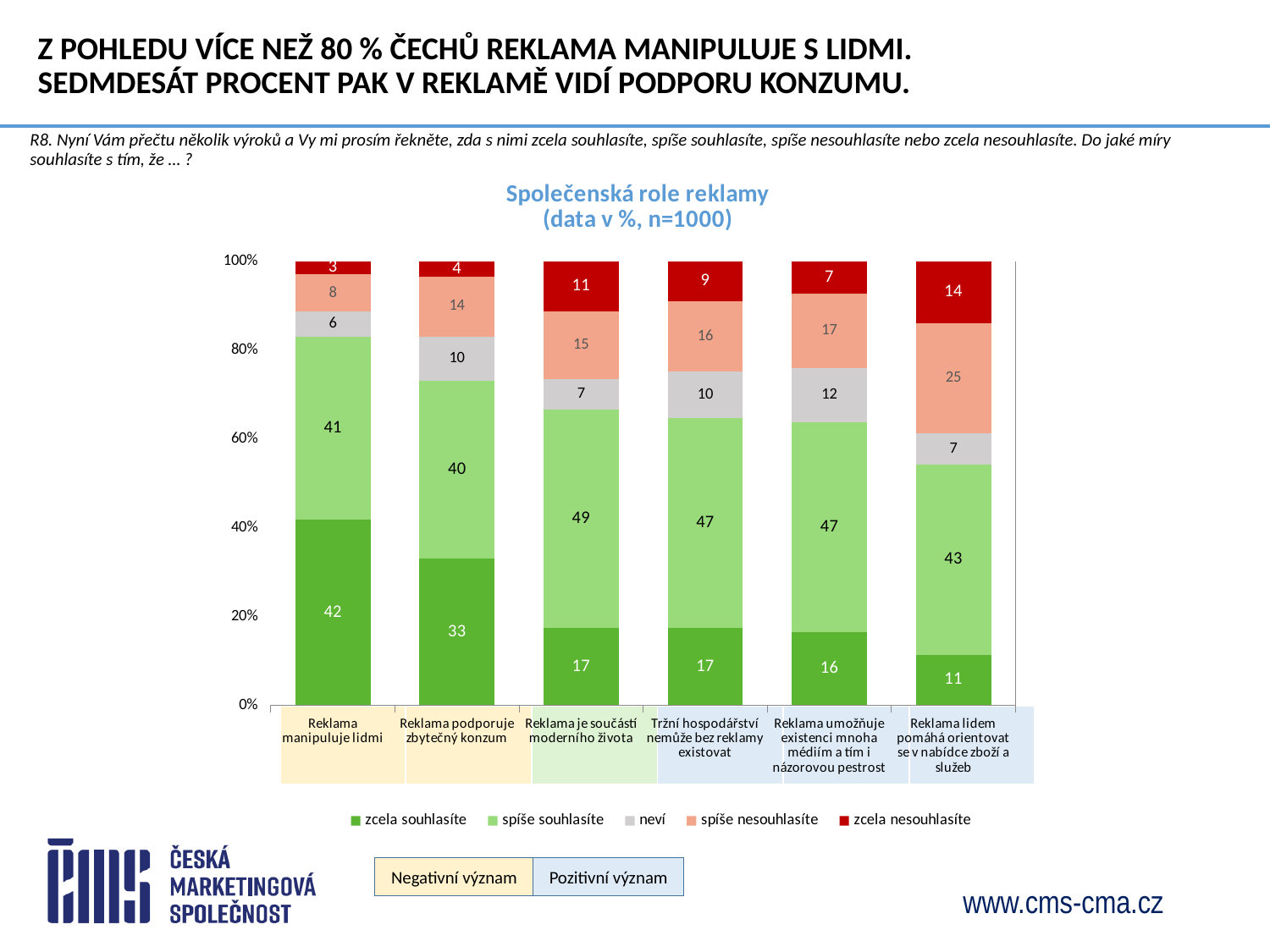
Which is larger: the "zcela nesouhlasíte" value for "Reklama je součástí moderního života" or for "Tržní hospodářství nemůže bez reklamy existovat"? Reklama je součástí moderního života Which category has the highest value for "zcela souhlasíte"? Reklama manipuluje lidmi What kind of chart is shown on the slide? Stacked bar chart What is the total of the stacked bar for "Reklama manipuluje lidmi"? 100 How many categories are shown on the x axis? 6 Which category has the lowest value for "zcela souhlasíte"? Reklama lidem pomáhá orientovat se v nabídce zboží a služeb What is the title of the chart? Společenská role reklamy (data v %, n=1000) What is the value of "neví" for "Reklama umožňuje existenci mnoha médiím a tím i názorovou pestrost"? 12 What is the difference between the "spíše souhlasíte" values for "Reklama je součástí moderního života" and "Reklama podporuje zbytečný konzum"? 9 What is the value of "zcela souhlasíte" for "Reklama manipuluje lidmi"? 42 How many series does the legend list? 5 What is the value of "spíše nesouhlasíte" for "Reklama lidem pomáhá orientovat se v nabídce zboží a služeb"? 25